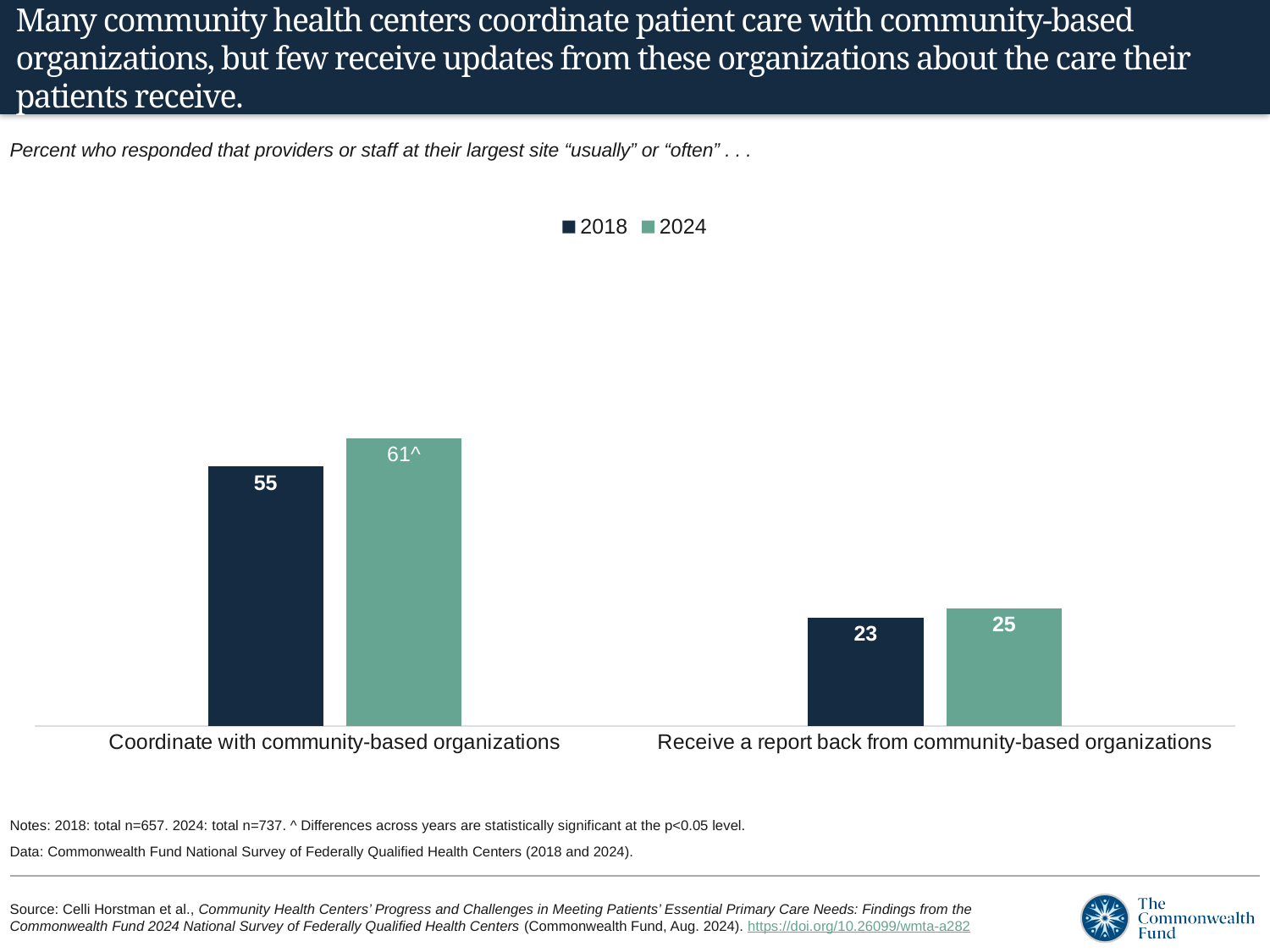
How many series does the legend list? 2 What is the difference between the 2018 values for "Coordinate with community-based organizations" and "Receive a report back from community-based organizations"? 32 What is the 2018 value for "Coordinate with community-based organizations"? 55 What is the 2018 value for "Receive a report back from community-based organizations"? 23 What kind of chart is shown on the slide? Bar chart What is the difference between the 2024 and 2018 values for "Coordinate with community-based organizations"? 6 What is the 2024 value for "Coordinate with community-based organizations"? 61 How many categories are shown on the x axis? 2 Which category has the lowest 2018 value? Receive a report back from community-based organizations What is the 2024 value for "Receive a report back from community-based organizations"? 25 Which category has the highest 2024 value? Coordinate with community-based organizations Which is larger: the 2018 value or the 2024 value for "Receive a report back from community-based organizations"? 2024